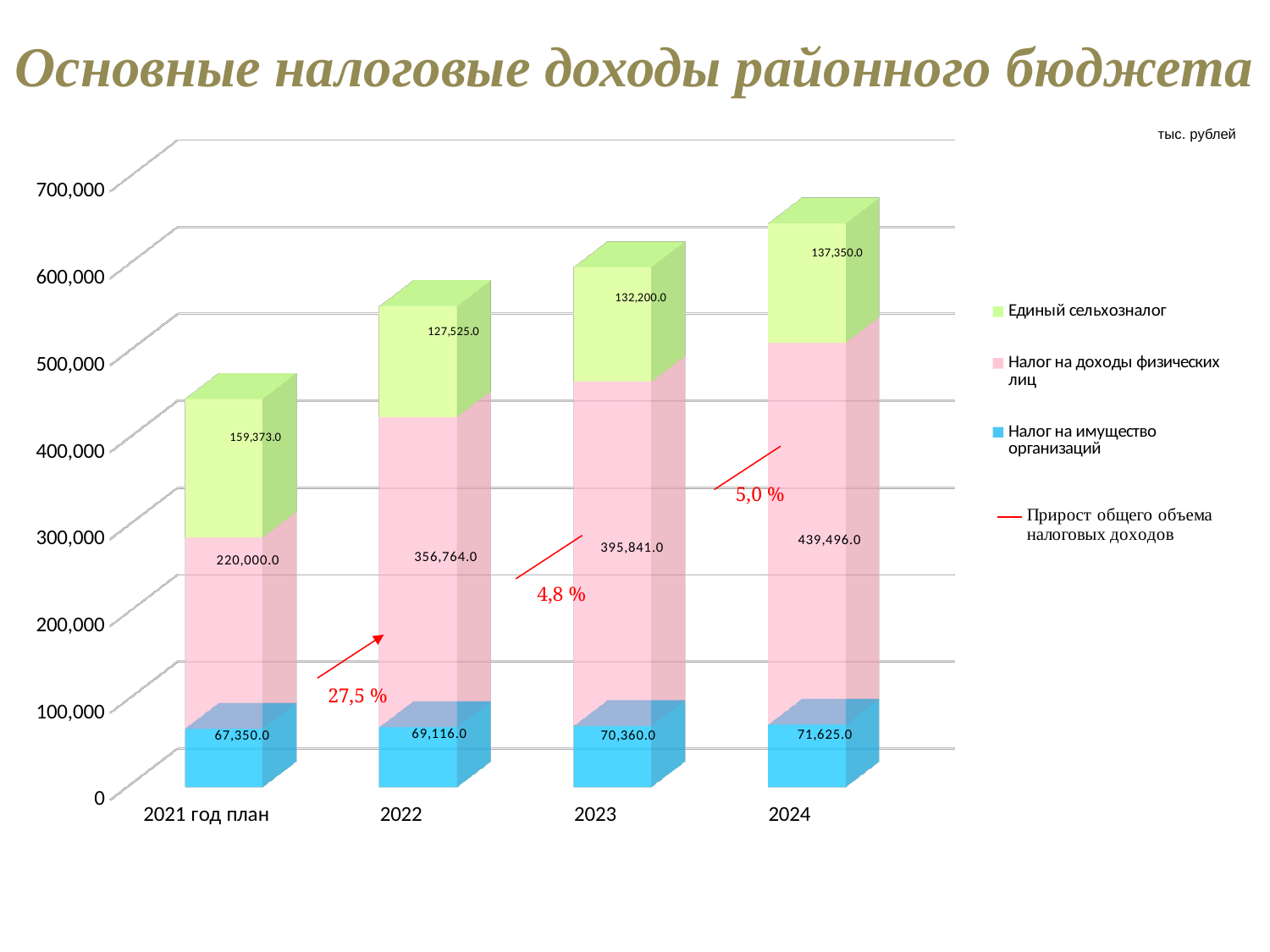
How many entries does the legend list? 4 In which year is Налог на доходы физических лиц the highest? 2024 What type of chart is shown on the slide? Stacked bar chart Which is larger: Единый сельхозналог in 2021 год план or in 2023? 2021 год план What is the total of the stacked bar for 2023? 598,401.0 What is the value of Единый сельхозналог for 2021 год план? 159,373.0 What growth percentage is annotated between 2021 год план and 2022? 27,5 % In which year is Единый сельхозналог the lowest? 2022 What is the value of Налог на доходы физических лиц for 2022? 356,764.0 How many years (categories) are shown on the x axis? 4 What is the value of Налог на имущество организаций for 2024? 71,625.0 What is the difference between Налог на доходы физических лиц in 2024 and in 2021 год план? 219,496.0